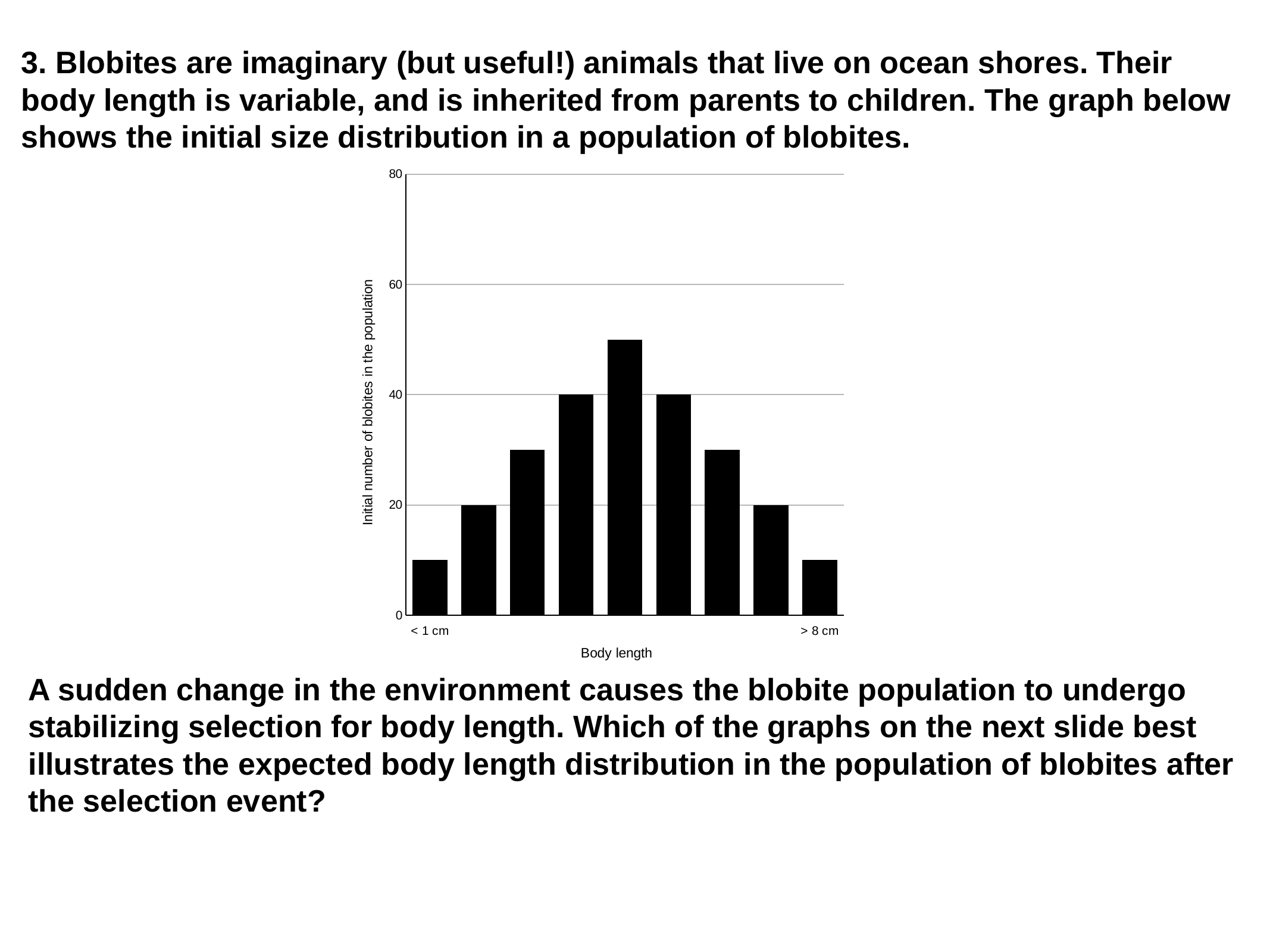
Do the bar heights rise or fall from the "< 1 cm" category toward the middle of the x axis? rise Is the tallest bar in the chart greater or less than 40? greater How many bars are plotted in the chart? 9 How many bars are taller than the 40 gridline? 1 Is the value for the "< 1 cm" body length category greater or less than 20? less Which bar is the tallest: the one at the left end, the one in the middle, or the one at the right end? the one in the middle What is the title of the x axis? Body length Is the value for the "> 8 cm" body length category greater or less than 20? less Do the bar heights rise or fall from the middle of the x axis toward the "> 8 cm" category? fall What kind of chart is shown on the slide? bar chart What is the title of the y axis? Initial number of blobites in the population